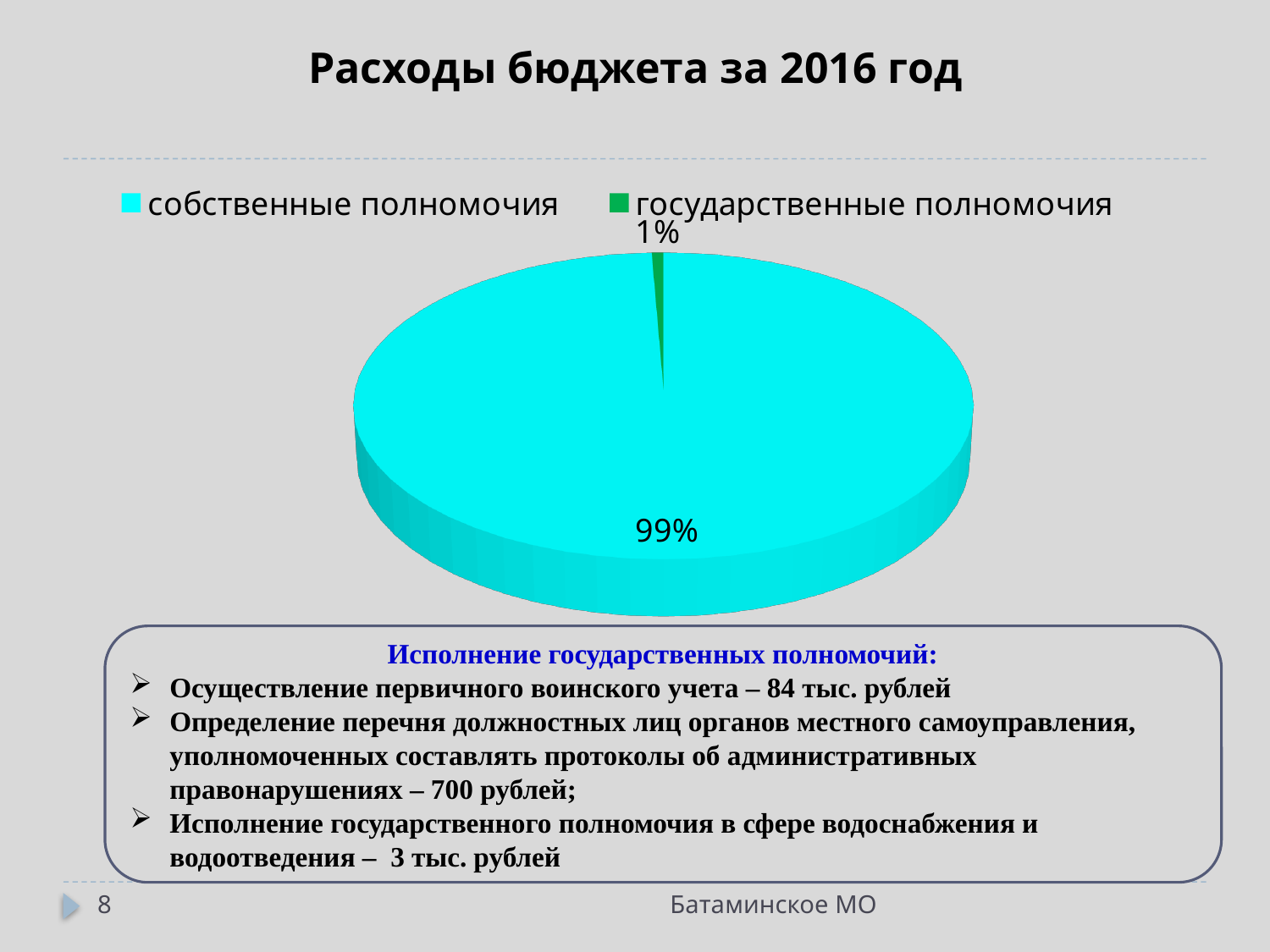
Which category has the largest slice of the pie? собственные полномочия How many categories does the pie chart show? 2 What colour is the slice for "государственные полномочия"? green What share of the pie does "государственные полномочия" take? 1% What is the title of the chart on the slide? Расходы бюджета за 2016 год What is the difference in percentage points between "собственные полномочия" and "государственные полномочия"? 98 What share of the pie does "собственные полномочия" take? 99% Which category has the smallest slice of the pie? государственные полномочия How many entries does the legend list? 2 Which is larger: the share for "собственные полномочия" or for "государственные полномочия"? собственные полномочия What kind of chart is shown on the slide? pie chart